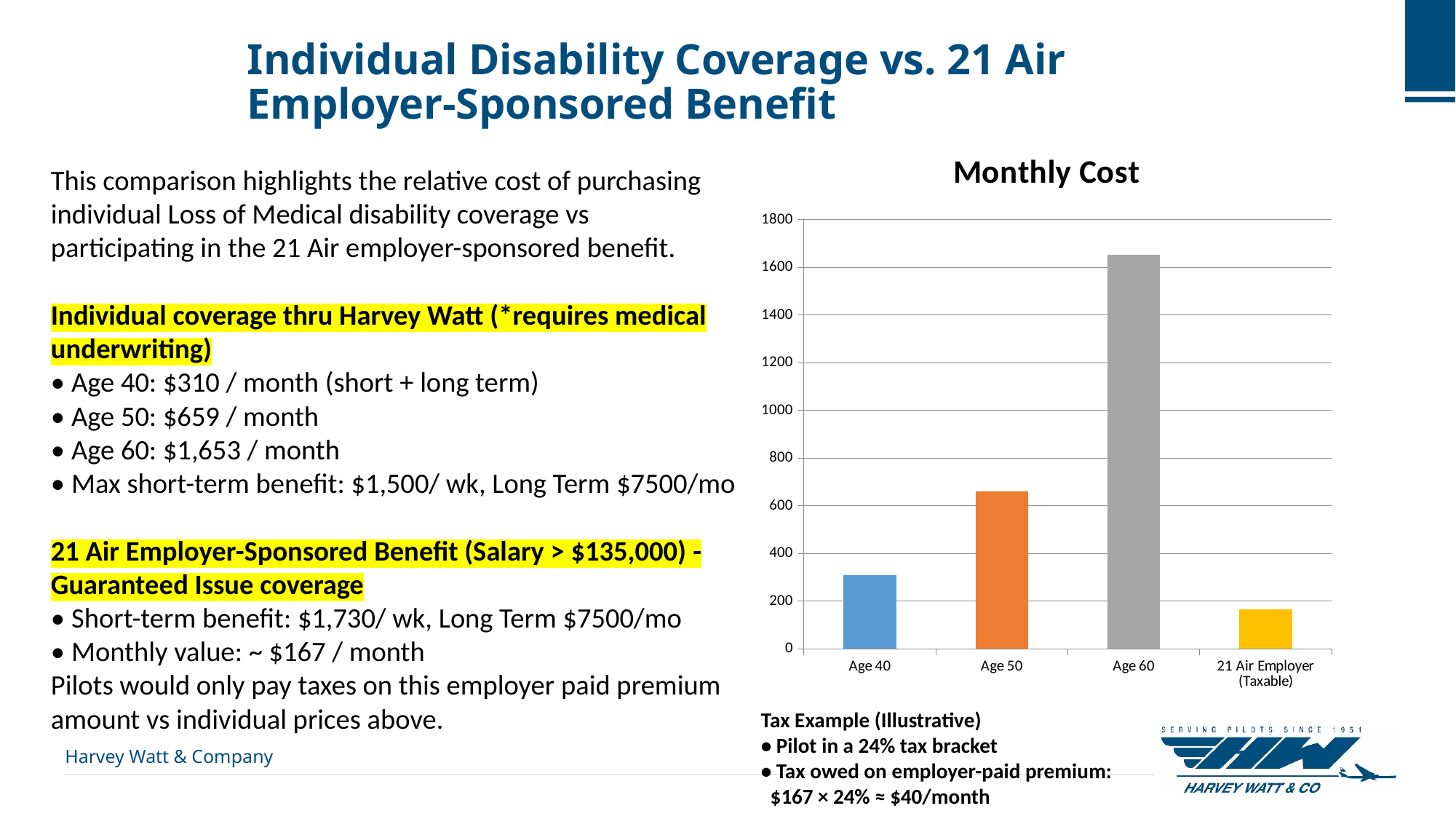
What is the title of the chart? Monthly Cost Is the monthly cost for Age 60 greater or less than 1600? greater Is the monthly cost for Age 50 greater or less than 600? greater Which category has the lowest monthly cost in the chart? 21 Air Employer (Taxable) Which has a higher monthly cost, Age 50 or Age 40? Age 50 Do the monthly costs rise or fall from Age 40 to Age 60? rise What is the maximum value shown on the y axis of the chart? 1800 Which category has the highest monthly cost in the chart? Age 60 What kind of chart is shown on the slide? bar chart Is the monthly cost for 21 Air Employer (Taxable) greater or less than 200? less How many categories are shown on the x axis of the Monthly Cost chart? 4